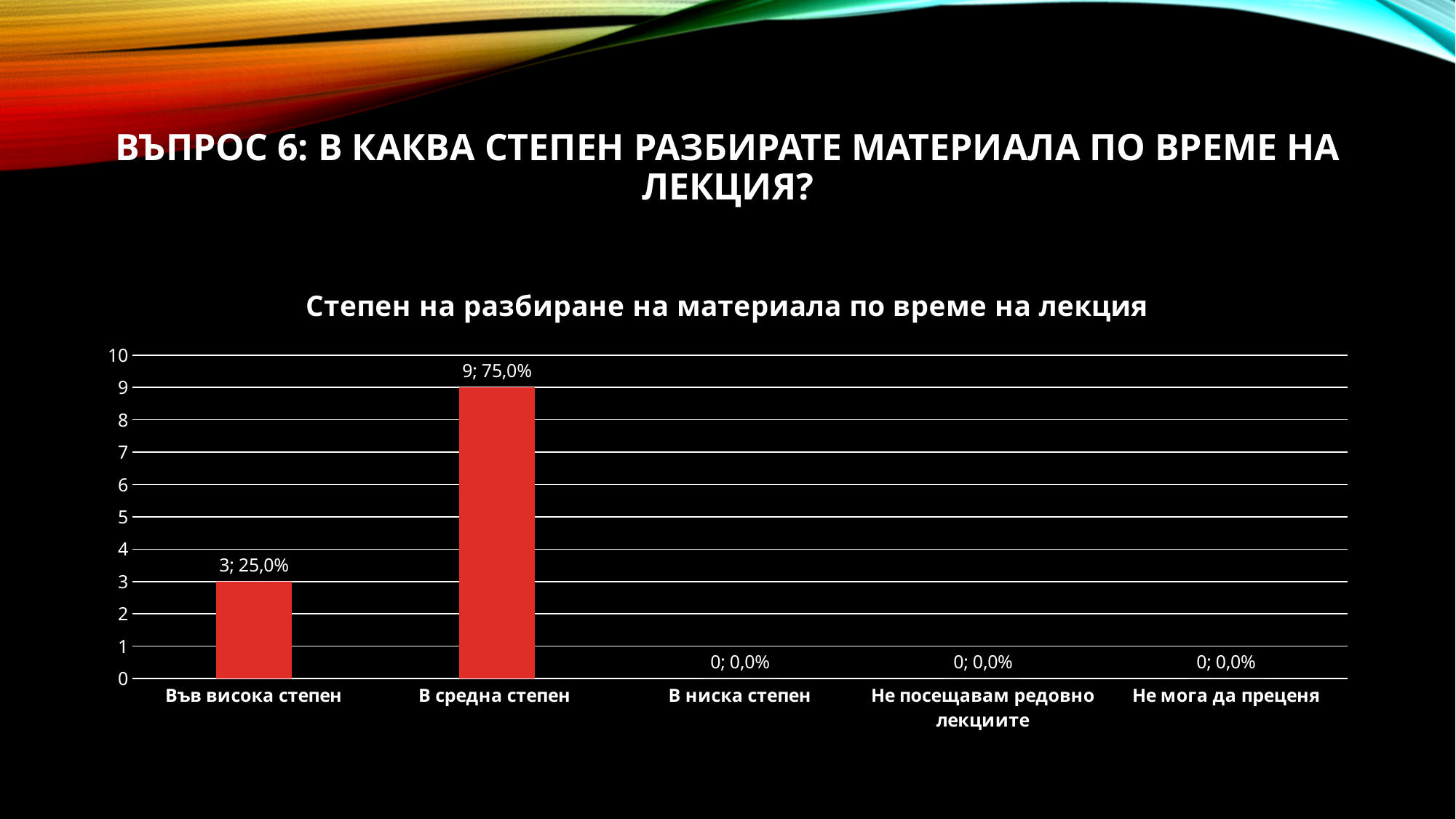
What is the difference between the counts for 'В средна степен' and 'Във висока степен'? 6 What is the value for 'Във висока степен'? 3; 25,0% What kind of chart is shown on the slide? bar chart What is the title of the chart? Степен на разбиране на материала по време на лекция Is the value for 'В средна степен' greater or less than 5? greater Which is larger, the value for 'Във висока степен' or 'Не мога да преценя'? Във висока степен What colour are the bars in the chart? red How many categories are shown on the x axis? 5 Which category has the highest value? В средна степен What is the total count across all categories? 12 What is the value for 'В средна степен'? 9; 75,0% What is the value for 'В ниска степен'? 0; 0,0%